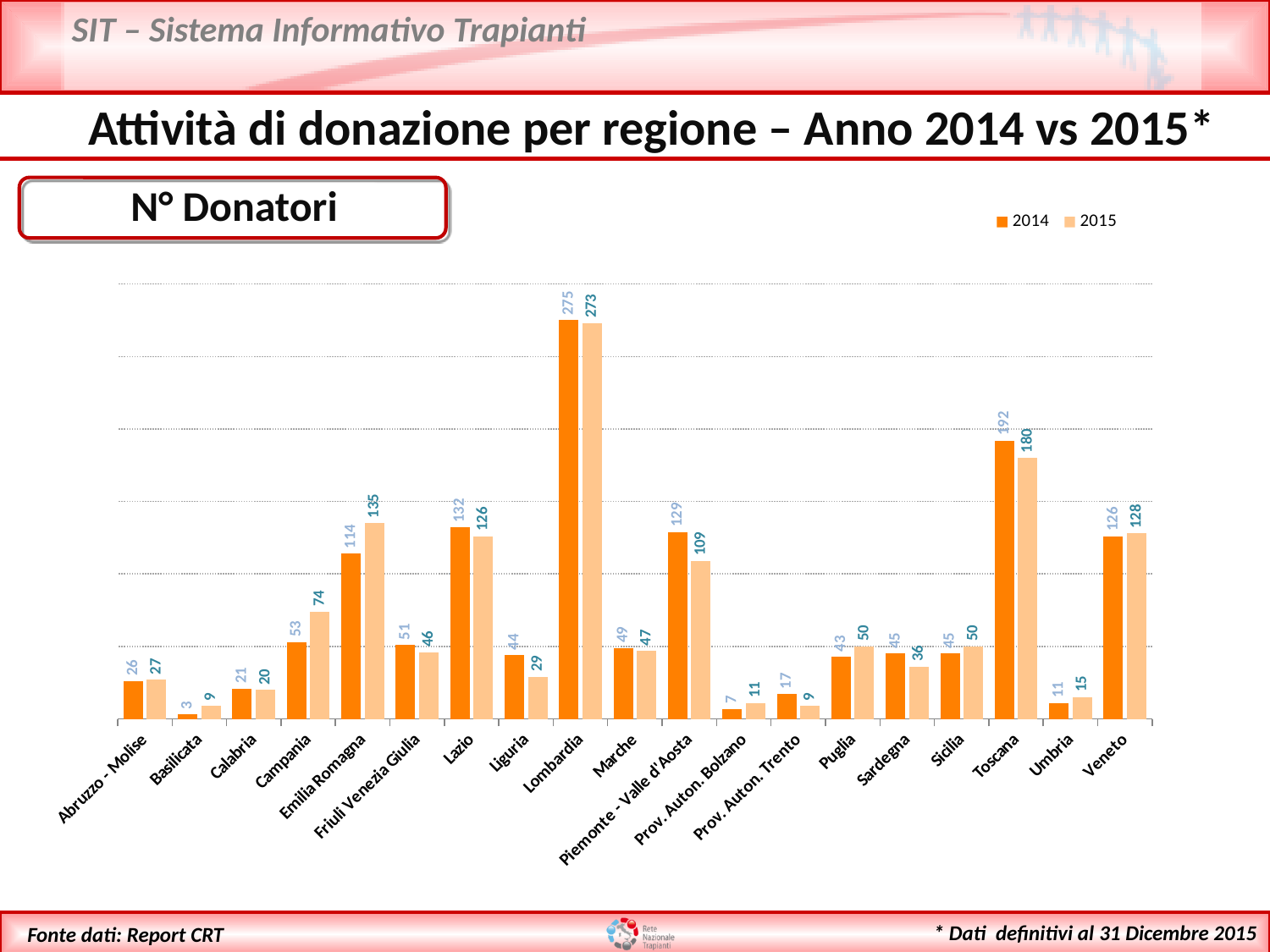
How many regions are shown on the x axis of the chart? 19 What is the number of donors for Toscana in 2015? 180 What is the difference between the 2014 and 2015 donor counts for Toscana? 12 Which is larger for Liguria: the 2014 value or the 2015 value? 2014 What kind of chart is shown on the slide? Bar chart How many series does the legend list? 2 What is the number of donors for Lombardia in 2014? 275 Which region has the lowest number of donors in 2014? Basilicata Which is larger for Puglia: the 2014 value or the 2015 value? 2015 What is the number of donors for Emilia Romagna in 2015? 135 Which region has the highest number of donors in 2015? Lombardia What is the difference between the 2014 and 2015 donor counts for Campania? 21